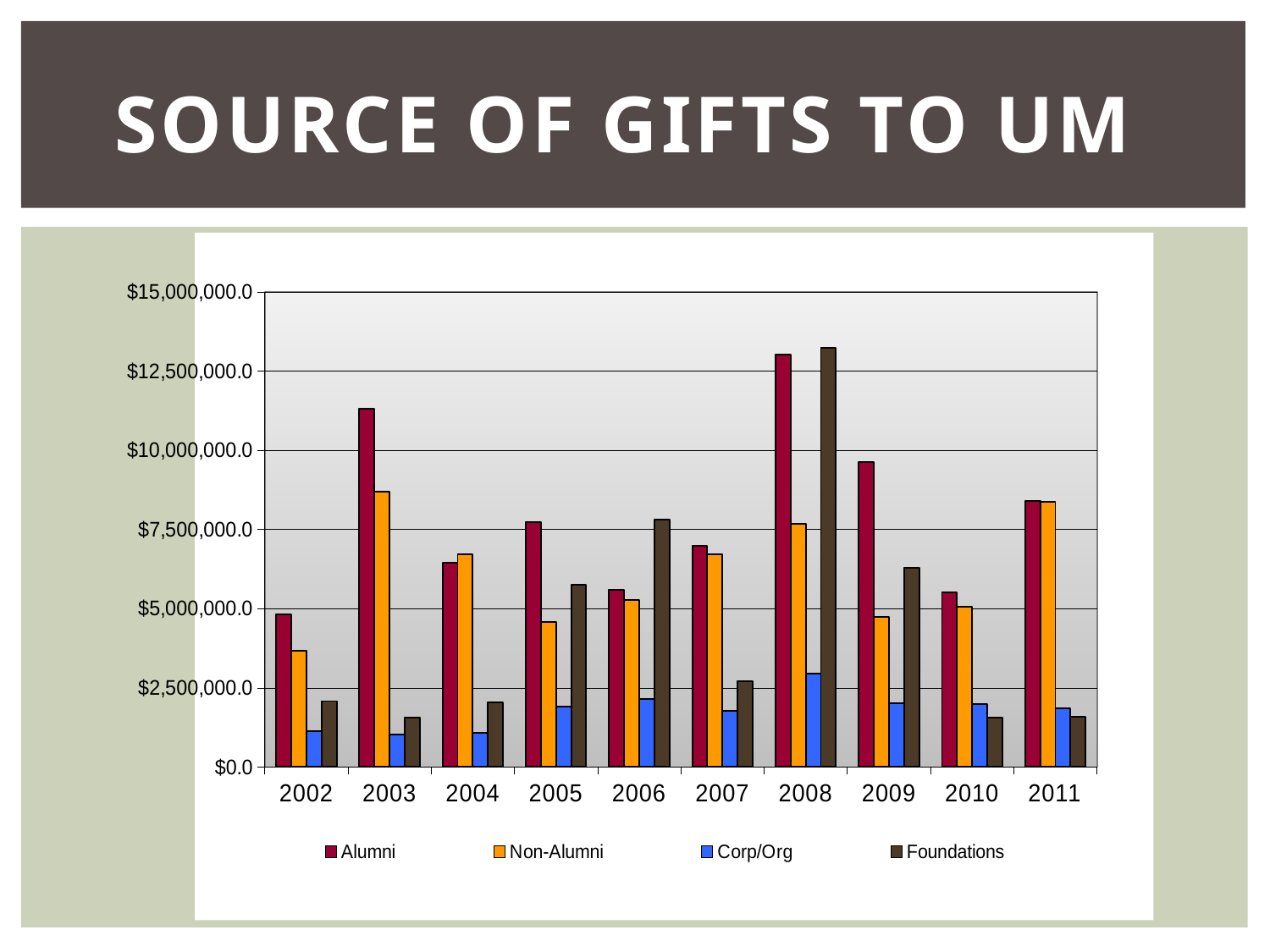
Is the Foundations value for 2008 greater or less than $12,500,000.0? greater How many series does the legend list? 4 In 2006, which is larger: the Foundations value or the Alumni value? Foundations In which year is the Alumni value lowest? 2002 What colour are the Corp/Org bars? blue In which year is the Alumni value highest? 2008 How many years are shown on the x axis? 10 What kind of chart is shown on the slide? bar chart In 2009, which is larger: the Alumni value or the Non-Alumni value? Alumni Is the Non-Alumni value for 2003 greater or less than $7,500,000.0? greater Is the Alumni value for 2003 greater or less than $10,000,000.0? greater